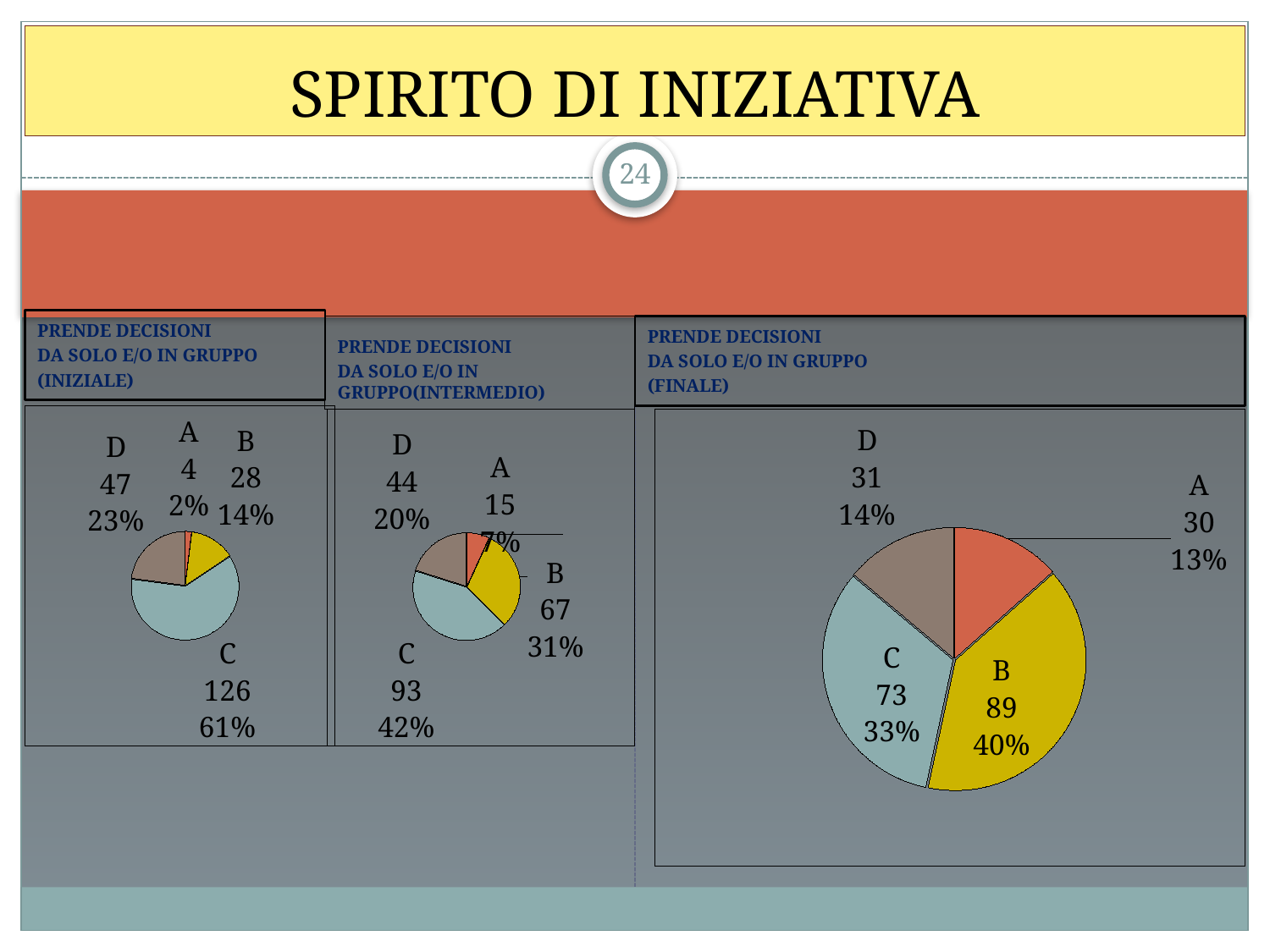
In the 'PRENDE DECISIONI DA SOLO E/O IN GRUPPO (FINALE)' chart, what share of the pie does category C have? 33% In the 'PRENDE DECISIONI DA SOLO E/O IN GRUPPO (FINALE)' chart, what is the value for category B? 89 In the 'PRENDE DECISIONI DA SOLO E/O IN GRUPPO(INTERMEDIO)' chart, what is the difference between the values for C and D? 49 How many charts are shown on the slide? 3 In the 'PRENDE DECISIONI DA SOLO E/O IN GRUPPO(INTERMEDIO)' chart, which category has the largest slice? C In the 'PRENDE DECISIONI DA SOLO E/O IN GRUPPO (FINALE)' chart, which is larger, the value for A or the value for D? D In the 'PRENDE DECISIONI DA SOLO E/O IN GRUPPO (INIZIALE)' chart, which category has the smallest slice? A What kind of chart is used in the 'PRENDE DECISIONI DA SOLO E/O IN GRUPPO (FINALE)' panel? Pie chart In the 'PRENDE DECISIONI DA SOLO E/O IN GRUPPO (FINALE)' chart, how many categories are shown? 4 In the 'PRENDE DECISIONI DA SOLO E/O IN GRUPPO(INTERMEDIO)' chart, what is the value for category B? 67 In the 'PRENDE DECISIONI DA SOLO E/O IN GRUPPO (INIZIALE)' chart, what share of the pie does category D have? 23% In the 'PRENDE DECISIONI DA SOLO E/O IN GRUPPO (INIZIALE)' chart, what is the value for category C? 126